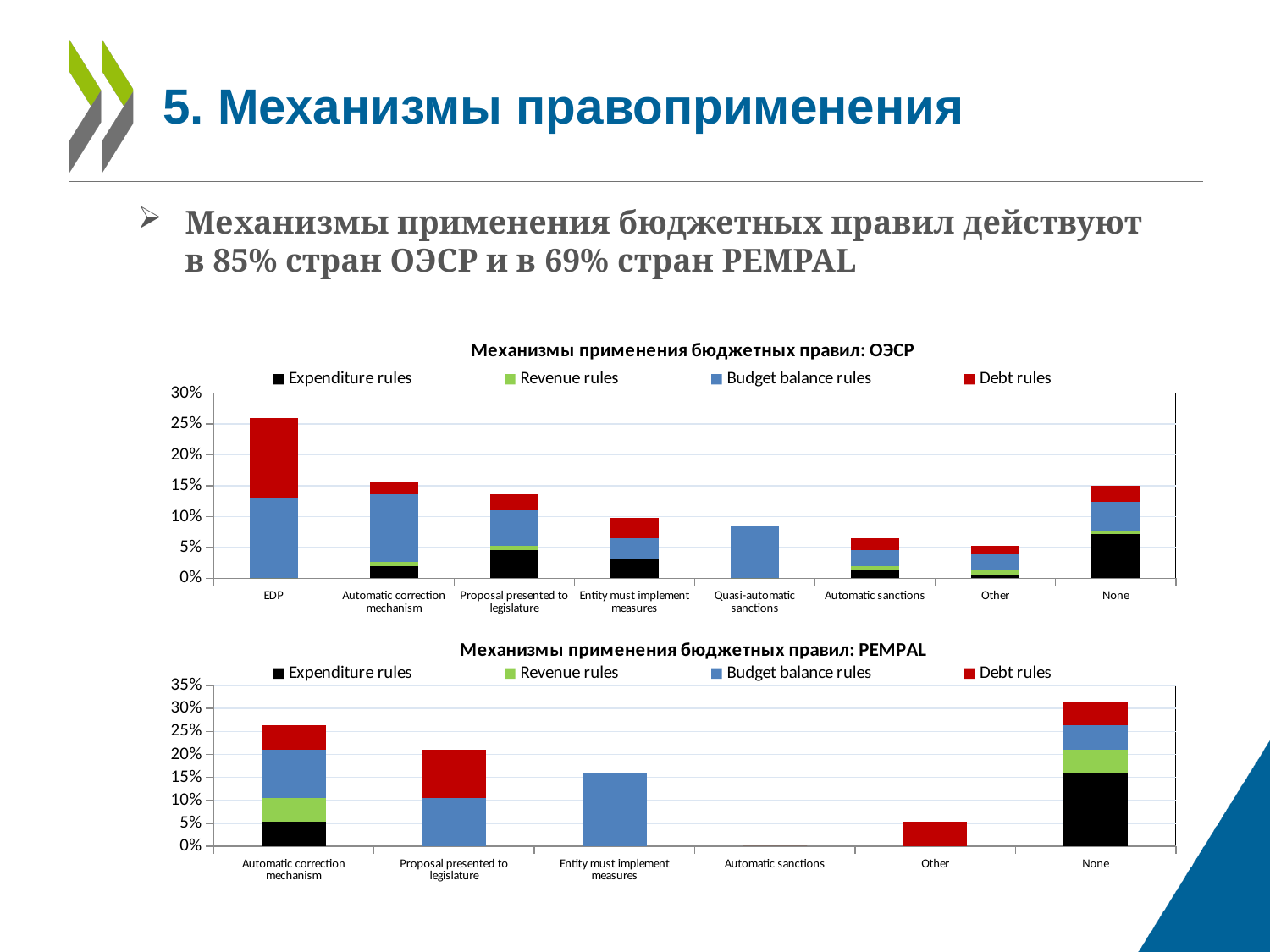
In the bottom chart (PEMPAL), which is larger, the total for Automatic correction mechanism or the total for Proposal presented to legislature? Automatic correction mechanism In the bottom chart (PEMPAL), which category has the highest total bar? None How many categories are shown on the x axis of the top chart (ОЭСР)? 8 How many categories are shown on the x axis of the bottom chart (PEMPAL)? 6 In the top chart (ОЭСР), which series is shown in red? Debt rules In the top chart (ОЭСР), is the total for EDP greater or less than 20%? greater In the bottom chart (PEMPAL), is the total for Other greater or less than 10%? less In the top chart (ОЭСР), which category has the highest total bar? EDP What kind of chart is the top chart titled 'Механизмы применения бюджетных правил: ОЭСР'? Stacked bar chart In the top chart (ОЭСР), is the total for Quasi-automatic sanctions greater or less than 10%? less In the top chart (ОЭСР), which is larger, the total for EDP or the total for None? EDP How many series does the legend of the top chart (ОЭСР) list? 4